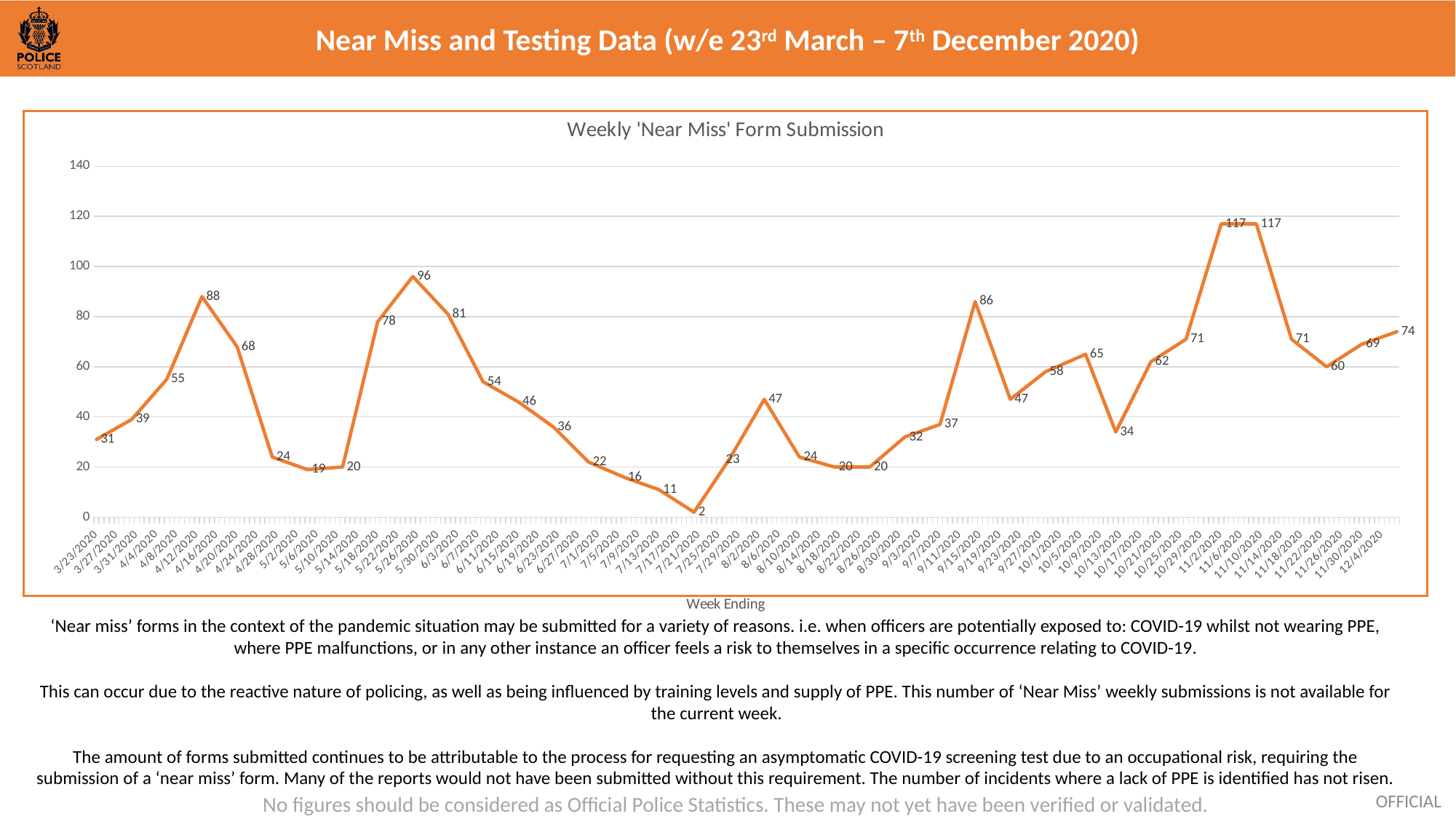
What is the value of the first data point on the chart (week ending 3/23/2020)? 31 What is the lowest weekly value plotted on the chart? 2 What is the title of the chart? Weekly 'Near Miss' Form Submission How much higher is the last data point (74) than the first data point (31)? 43 What type of chart is shown on the slide? line chart What is the value of the last data point on the chart? 74 What is the difference between the highest and lowest values on the chart? 115 What is the highest weekly value plotted on the chart? 117 Does the line end higher or lower than it starts? higher What is the label of the x axis? Week Ending Is the highest value on the chart greater or less than 100? greater Which is larger: the peak in late May (96) or the peak in mid-April (88)? 96